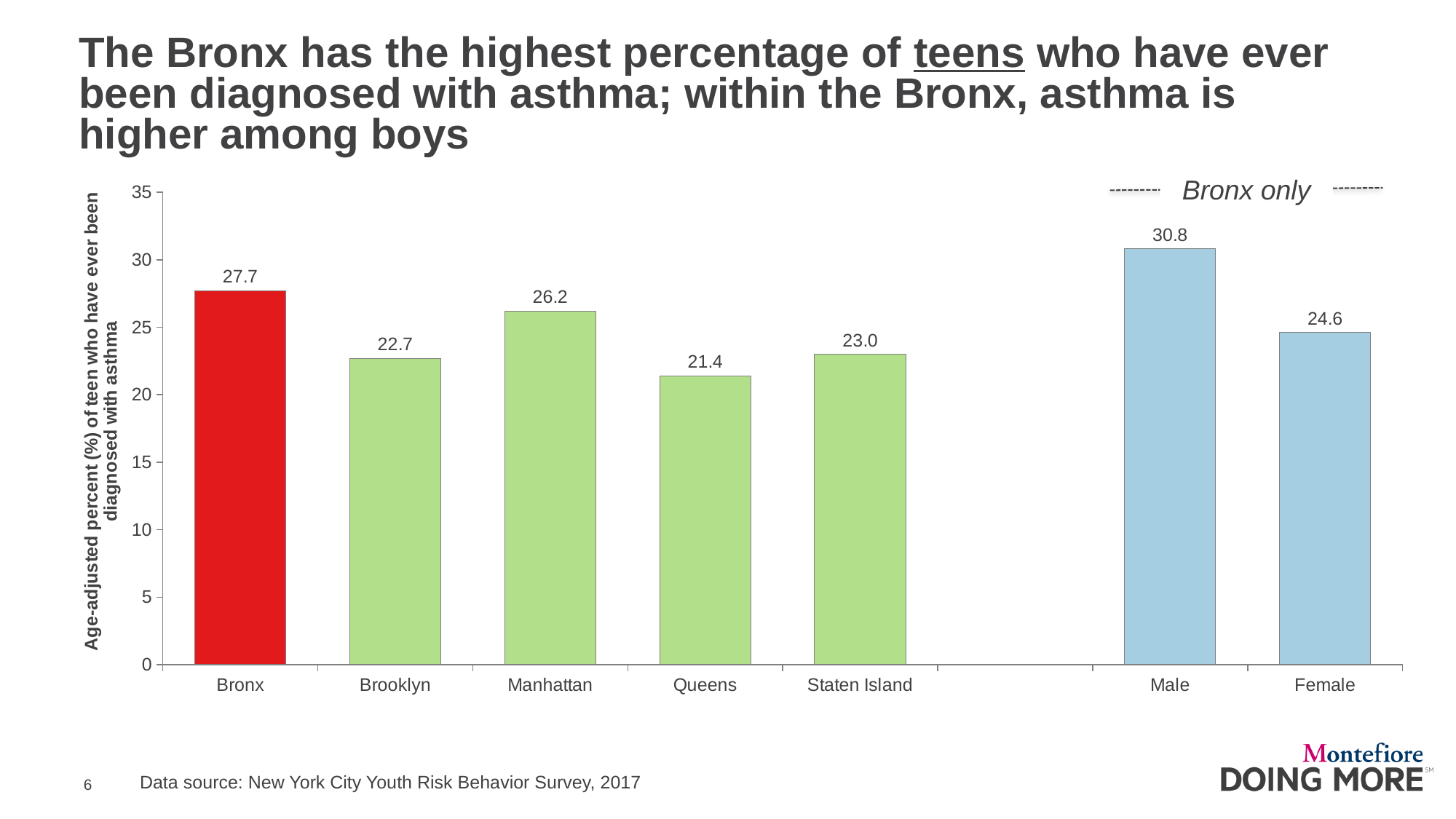
Which of the five boroughs has the highest value? Bronx What is the difference between the Bronx and Brooklyn values? 5.0 What is the difference between the Male and Female values? 6.2 What is the value for Female in the Bronx only section? 24.6 What is the value for Male in the Bronx only section? 30.8 How many bars are plotted on the chart? 7 What is the value for Queens? 21.4 Which of the five boroughs has the lowest value? Queens Is the value for Male greater or less than 30? greater What is the value for Bronx? 27.7 What kind of chart is shown on the slide? Bar chart Which is larger, the value for Manhattan or the value for Staten Island? Manhattan